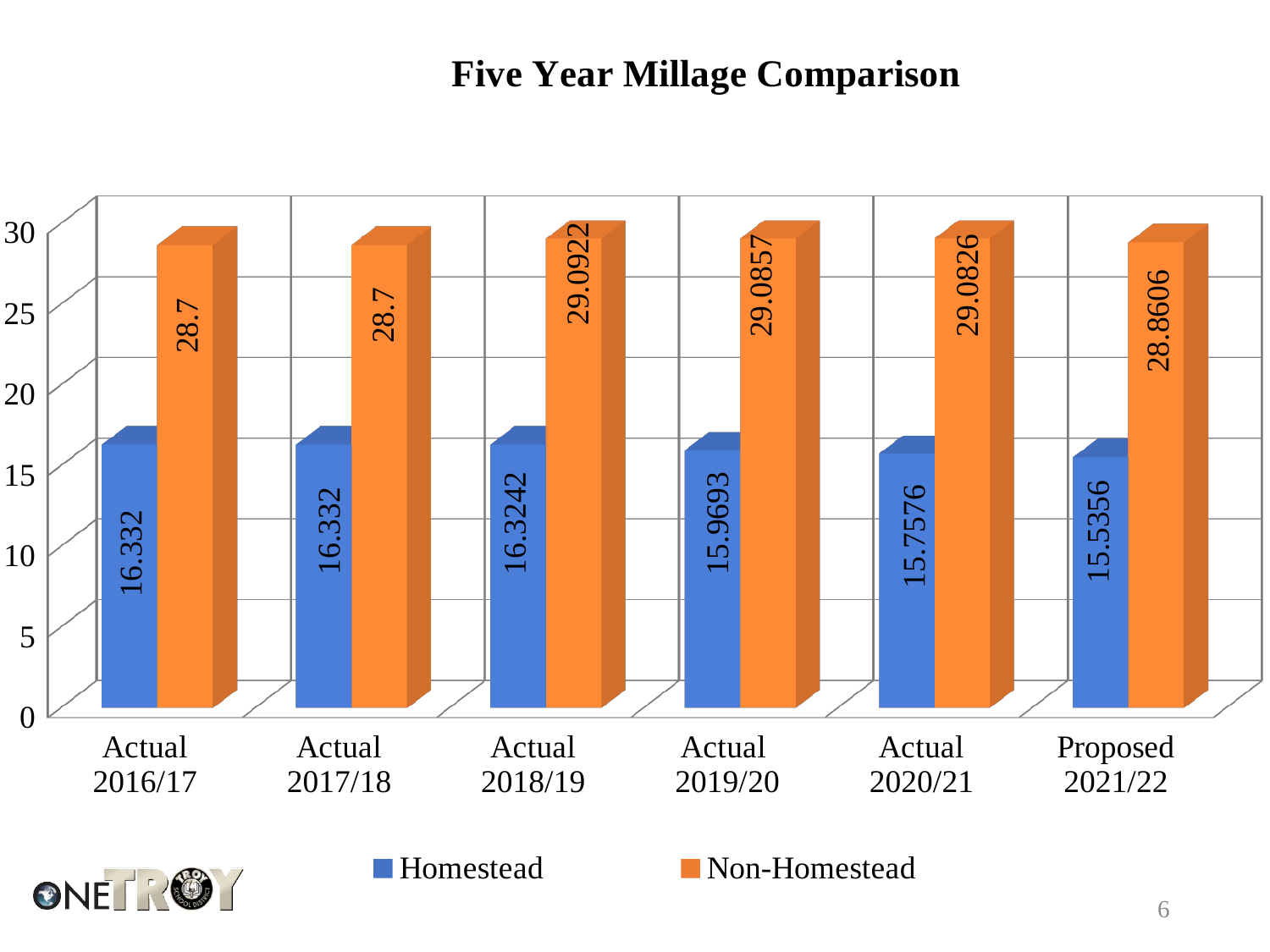
What is the Homestead millage for Actual 2020/21? 15.7576 How many series does the legend list? 2 Which year has the lowest Homestead millage? Proposed 2021/22 What is the Homestead millage for Actual 2016/17? 16.332 How many years are shown on the x axis? 6 Is the Non-Homestead millage for Actual 2016/17 greater or less than 25? greater What is the difference between the Non-Homestead and Homestead millage for Actual 2019/20? 13.1164 Which year has the highest Non-Homestead millage? Actual 2018/19 What is the Non-Homestead millage for Proposed 2021/22? 28.8606 What kind of chart is shown on the slide? bar chart Is the Homestead millage for Actual 2019/20 higher or lower than for Actual 2020/21? higher What is the Non-Homestead millage for Actual 2018/19? 29.0922